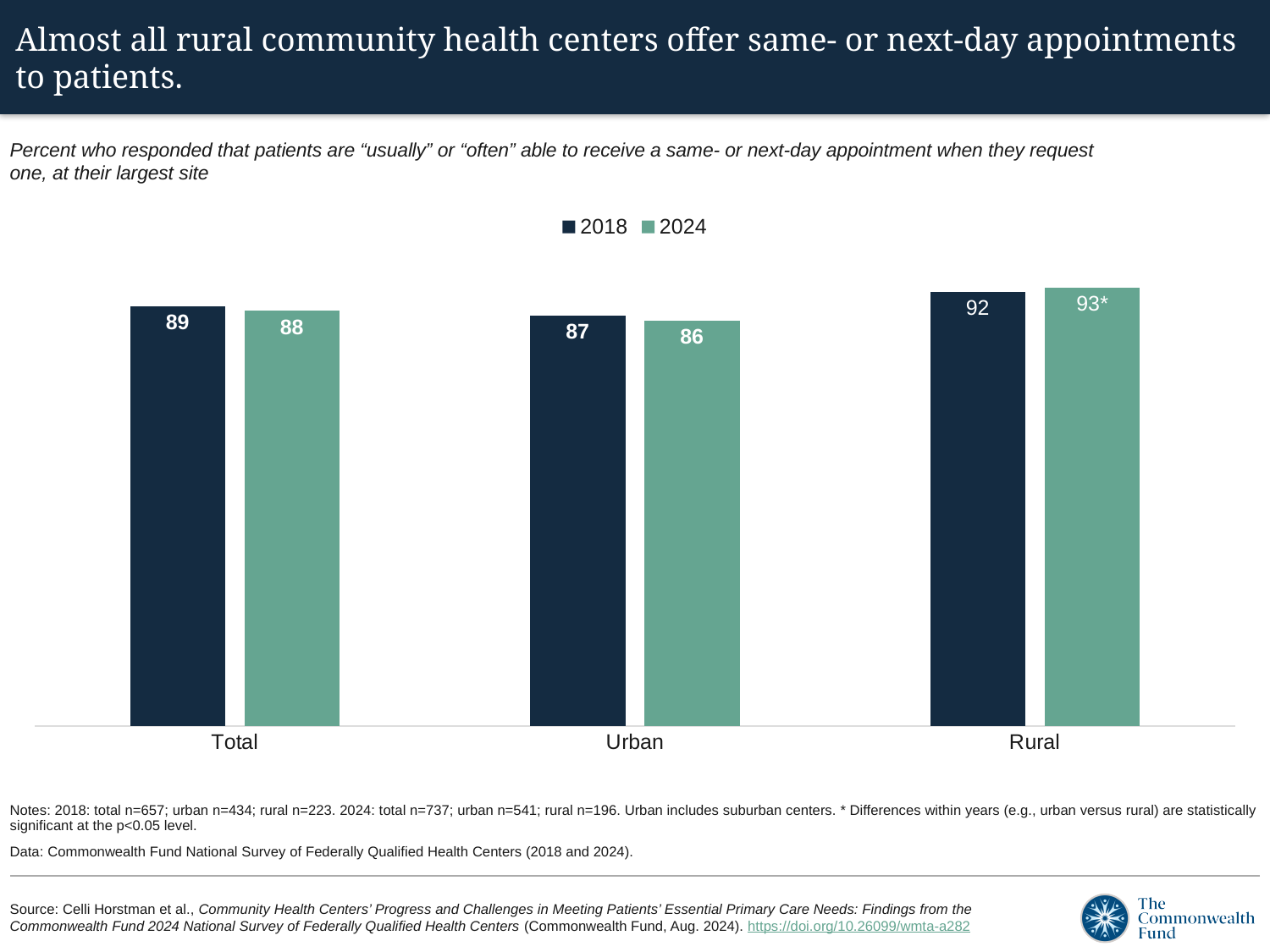
How many categories are shown on the x axis? 3 Which is larger, the 2018 value for Urban or the 2018 value for Rural? Rural What kind of chart is shown on the slide? Bar chart What is the difference between the Rural and Urban values for 2024? 7 What is the 2018 value for Total? 89 How many series does the legend list? 2 Which category has the highest 2024 value? Rural What is the 2024 value for Urban? 86 What is the 2024 value for Rural? 93* What is the 2018 value for Rural? 92 What is the difference between the 2018 and 2024 values for Total? 1 Which category has the lowest 2018 value? Urban